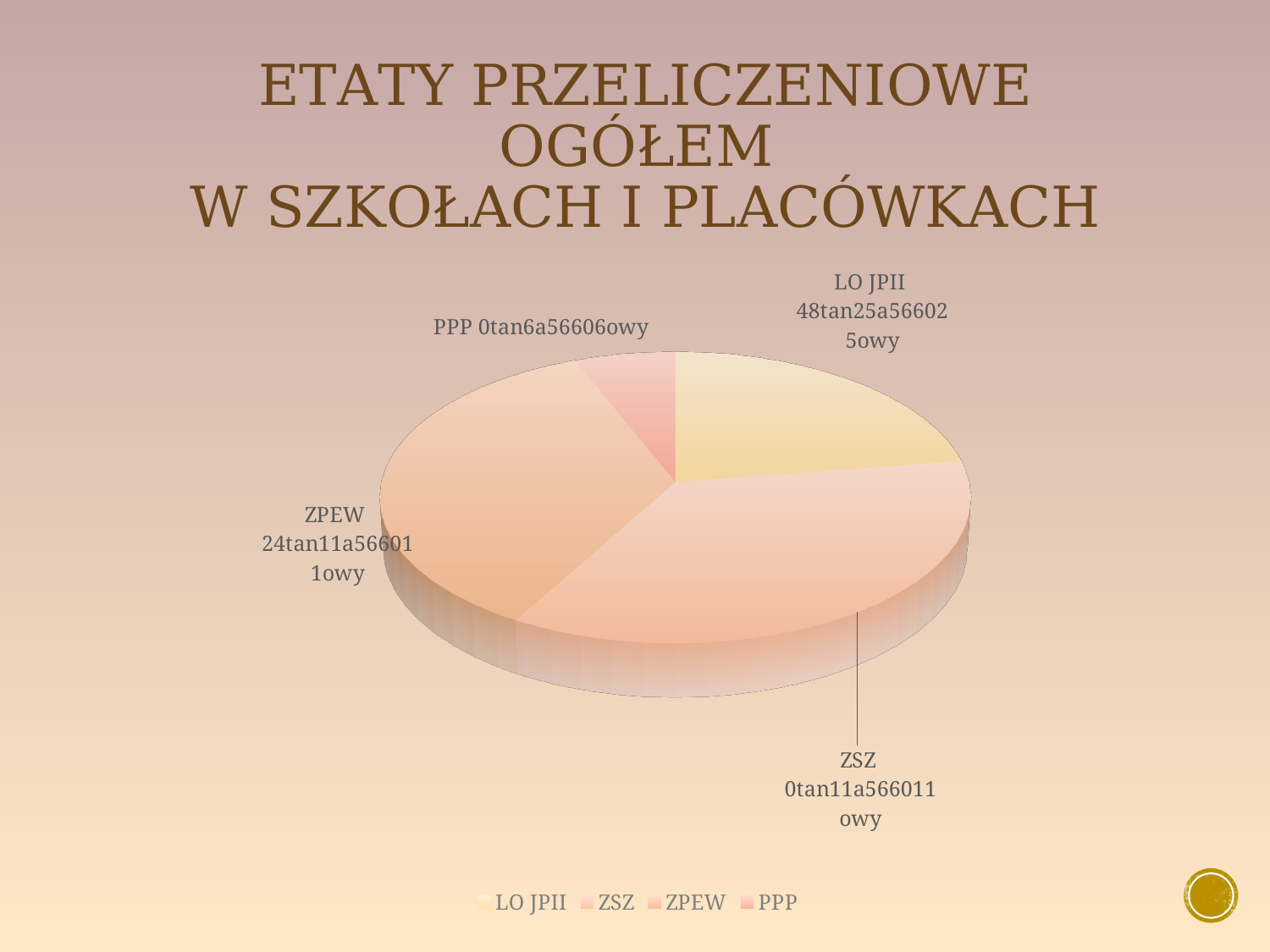
Which category is listed first in the legend? LO JPII What is the title of the slide? ETATY PRZELICZENIOWE OGÓŁEM W SZKOŁACH I PLACÓWKACH Which slice is larger, LO JPII or PPP? LO JPII How many entries does the legend list? 4 Which slice is larger, ZSZ or PPP? ZSZ Which slice is larger, ZPEW or PPP? ZPEW Which category has the smallest slice of the pie? PPP How many slices does the pie chart have? 4 What kind of chart is shown on the slide? pie chart